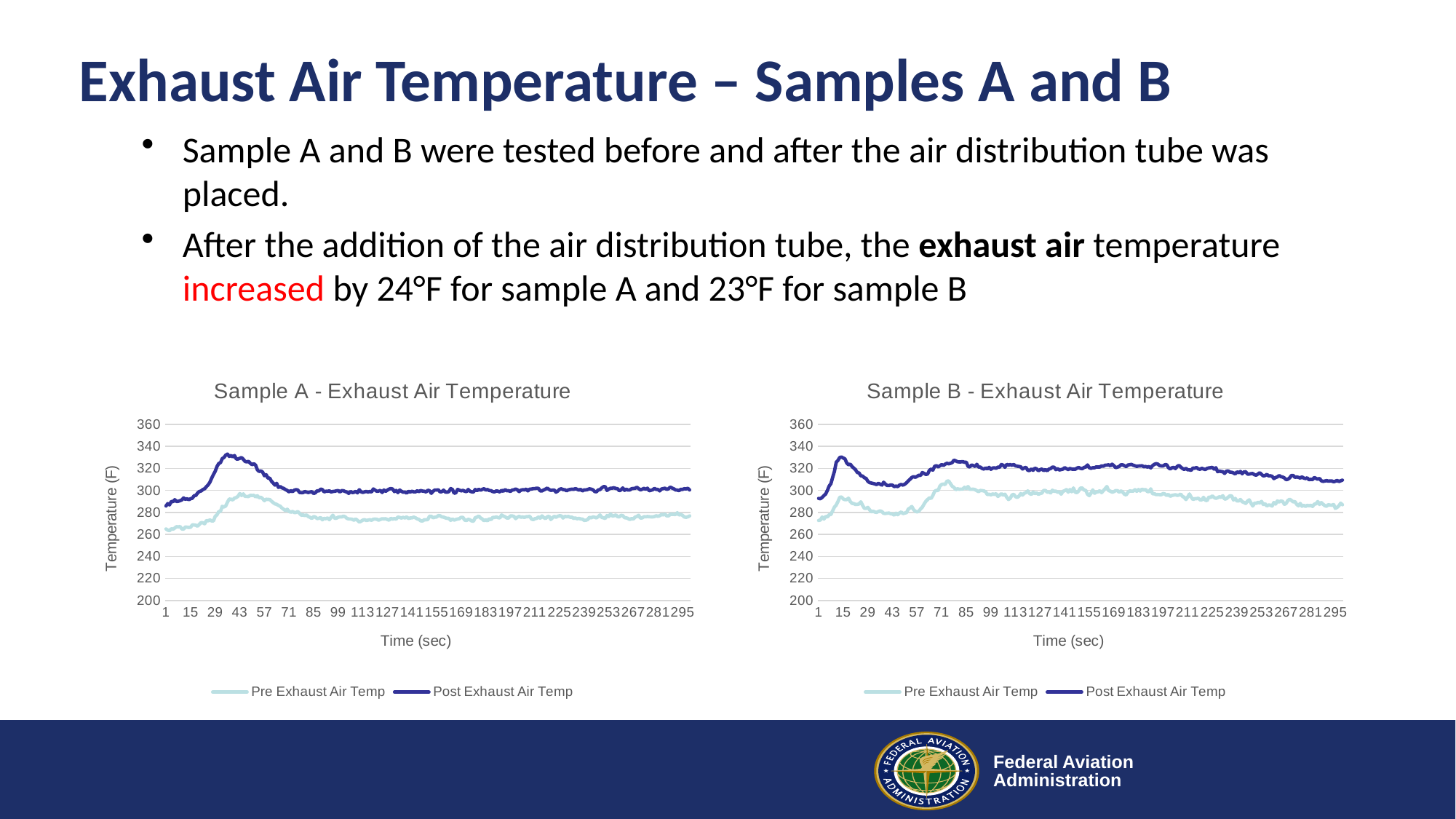
What is the y-axis label of the Sample A - Exhaust Air Temperature chart? Temperature (F) What kind of chart is the Sample A - Exhaust Air Temperature chart? line chart In the Sample B - Exhaust Air Temperature chart, does the Pre Exhaust Air Temp series rise or fall between time 43 and time 71? rise In the Sample A - Exhaust Air Temperature chart, does the Post Exhaust Air Temp series rise or fall between time 43 and time 71? fall What is the x-axis label of the Sample B - Exhaust Air Temperature chart? Time (sec) In the Sample B - Exhaust Air Temperature chart, is the Pre Exhaust Air Temp value at time 1 greater or less than 280? less In the Sample A - Exhaust Air Temperature chart, which series is higher at time 295: Pre Exhaust Air Temp or Post Exhaust Air Temp? Post Exhaust Air Temp In the Sample A - Exhaust Air Temperature chart, is the peak of the Post Exhaust Air Temp series greater or less than 320? greater How many series does the legend of the Sample B - Exhaust Air Temperature chart list? 2 In the Sample A - Exhaust Air Temperature chart, is the Pre Exhaust Air Temp value at time 1 greater or less than 280? less In the Sample B - Exhaust Air Temperature chart, which series is higher at time 295: Pre Exhaust Air Temp or Post Exhaust Air Temp? Post Exhaust Air Temp